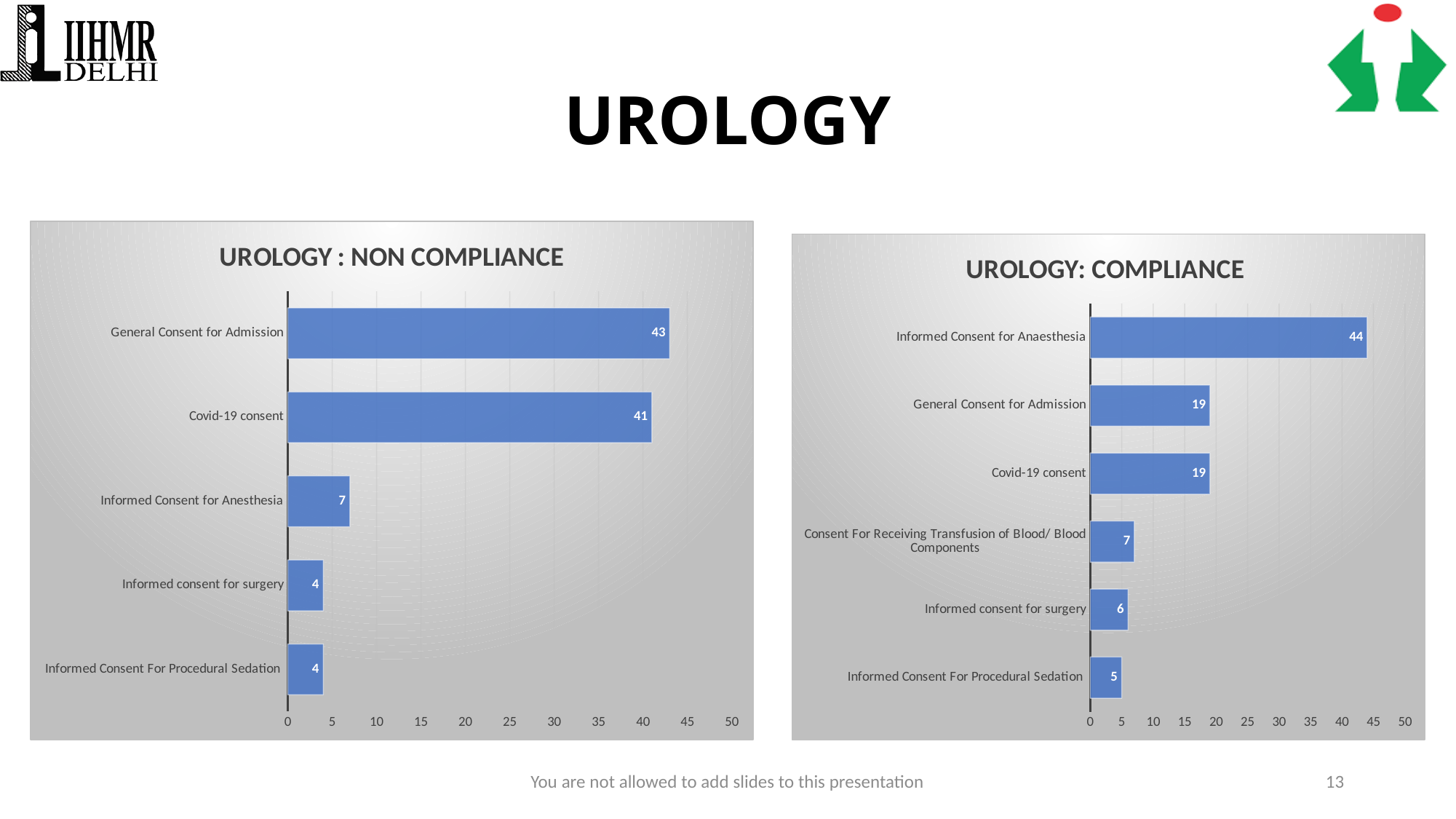
In the UROLOGY: COMPLIANCE chart, what is the value for Informed Consent for Anaesthesia? 44 In the UROLOGY: COMPLIANCE chart, what is the value for Consent For Receiving Transfusion of Blood/ Blood Components? 7 In the UROLOGY : NON COMPLIANCE chart, what is the difference between General Consent for Admission and Informed Consent for Anesthesia? 36 In the UROLOGY: COMPLIANCE chart, how many categories are shown? 6 Which is larger: Informed consent for surgery in the UROLOGY : NON COMPLIANCE chart or Informed consent for surgery in the UROLOGY: COMPLIANCE chart? UROLOGY: COMPLIANCE What kind of chart is the UROLOGY: COMPLIANCE chart? Bar chart In the UROLOGY : NON COMPLIANCE chart, what is the value for Covid-19 consent? 41 In the UROLOGY : NON COMPLIANCE chart, which category has the highest value? General Consent for Admission In the UROLOGY : NON COMPLIANCE chart, what is the value for General Consent for Admission? 43 In the UROLOGY : NON COMPLIANCE chart, how many categories are shown? 5 In the UROLOGY: COMPLIANCE chart, which category has the lowest value? Informed Consent For Procedural Sedation In the UROLOGY: COMPLIANCE chart, is the value for Informed Consent for Anaesthesia greater or less than 40? greater